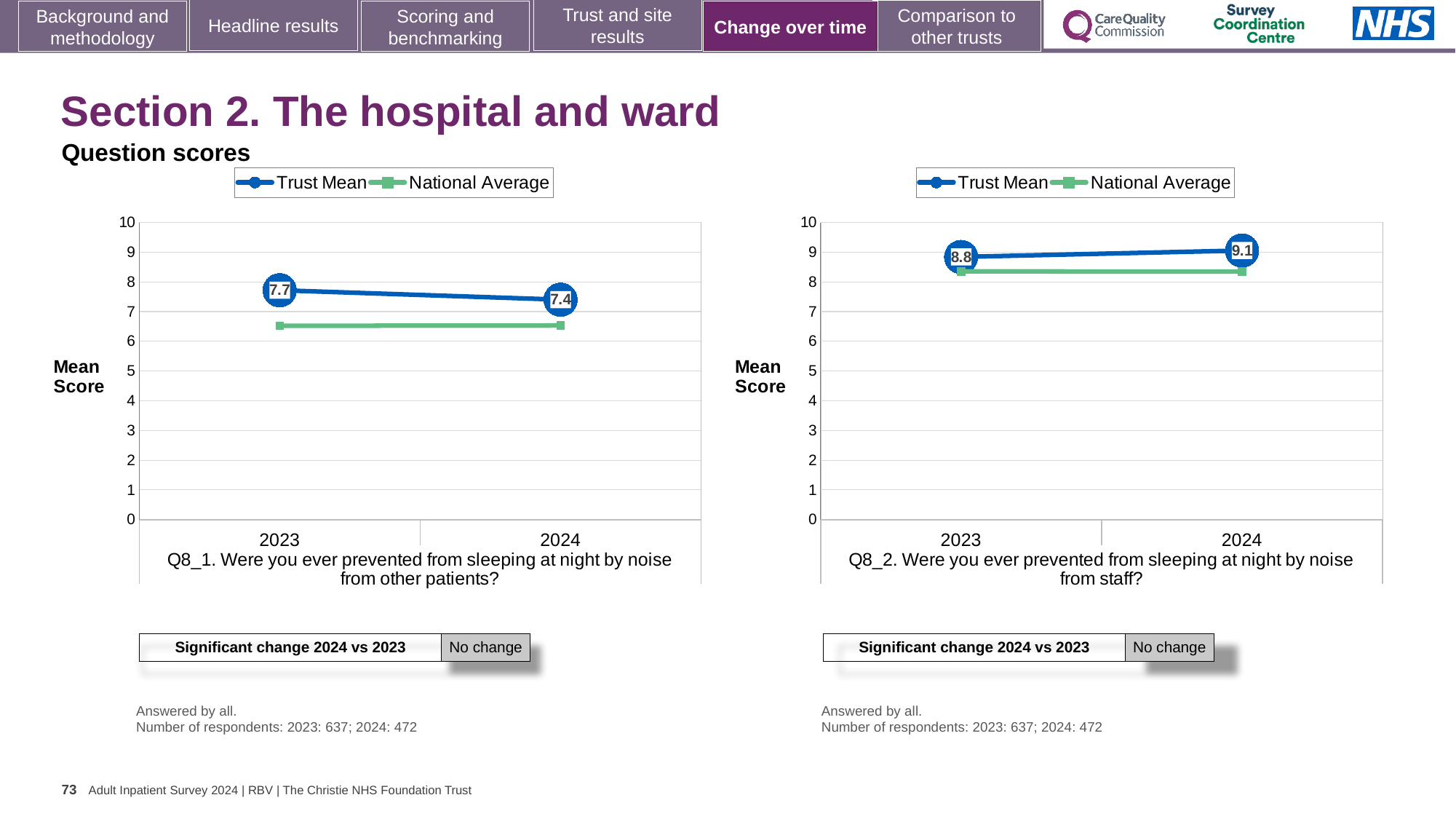
How many series does the legend of the Q8_1 chart (left) list? 2 What type of chart is used for Q8_2 (right)? line chart In the Q8_1 chart (left), by how much did the Trust Mean change from 2023 to 2024? 0.3 In the Q8_2 chart (right), what is the Trust Mean score for 2024? 9.1 In the Q8_1 chart (left), what is the Trust Mean score for 2023? 7.7 In the Q8_2 chart (right), what is the difference between the Trust Mean in 2024 and 2023? 0.3 In the Q8_2 chart (right), which is higher in 2023, the Trust Mean or the National Average? Trust Mean In the Q8_2 chart (right), what is the Trust Mean score for 2023? 8.8 In the Q8_2 chart (right), does the Trust Mean rise or fall from 2023 to 2024? rise In the Q8_1 chart (left), is the National Average for 2024 greater or less than 7? less In the Q8_1 chart (left), what is the Trust Mean score for 2024? 7.4 In the Q8_1 chart (left), does the Trust Mean rise or fall from 2023 to 2024? fall